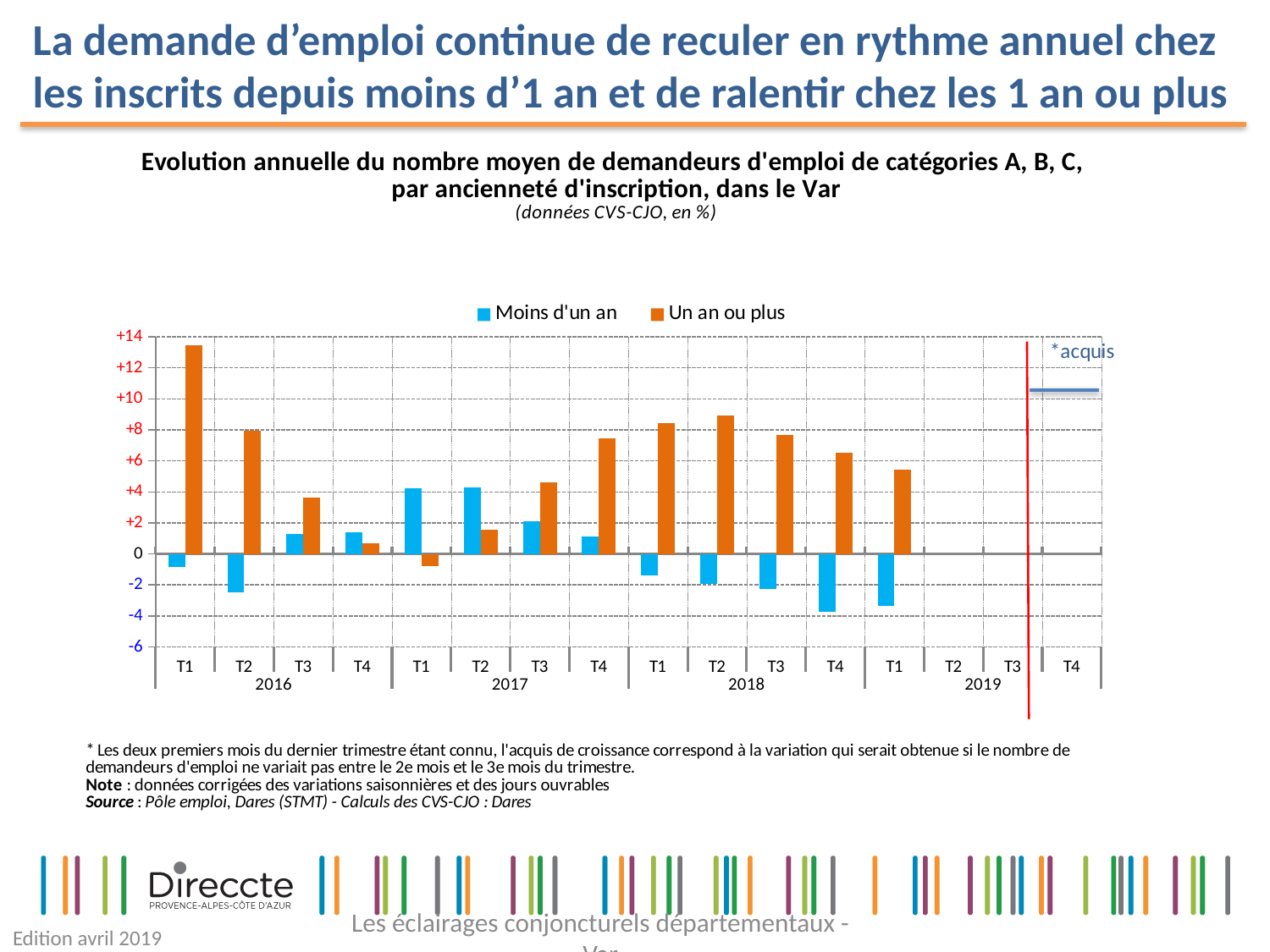
Is the value for 'Moins d'un an' in T1 2017 greater or less than +2? greater Is the value for 'Un an ou plus' in T1 2016 greater or less than +12? greater Do the values for 'Moins d'un an' rise or fall from T1 2018 to T4 2018? fall What kind of chart is shown on the slide? bar chart In T1 2017, which series has the larger value, 'Moins d'un an' or 'Un an ou plus'? Moins d'un an Is the value for 'Moins d'un an' in T4 2018 greater or less than -2? less In T3 2017, which series has the larger value, 'Moins d'un an' or 'Un an ou plus'? Un an ou plus In which quarter is the value for 'Un an ou plus' the highest? T1 2016 Which series is shown in orange? Un an ou plus How many series does the legend list? 2